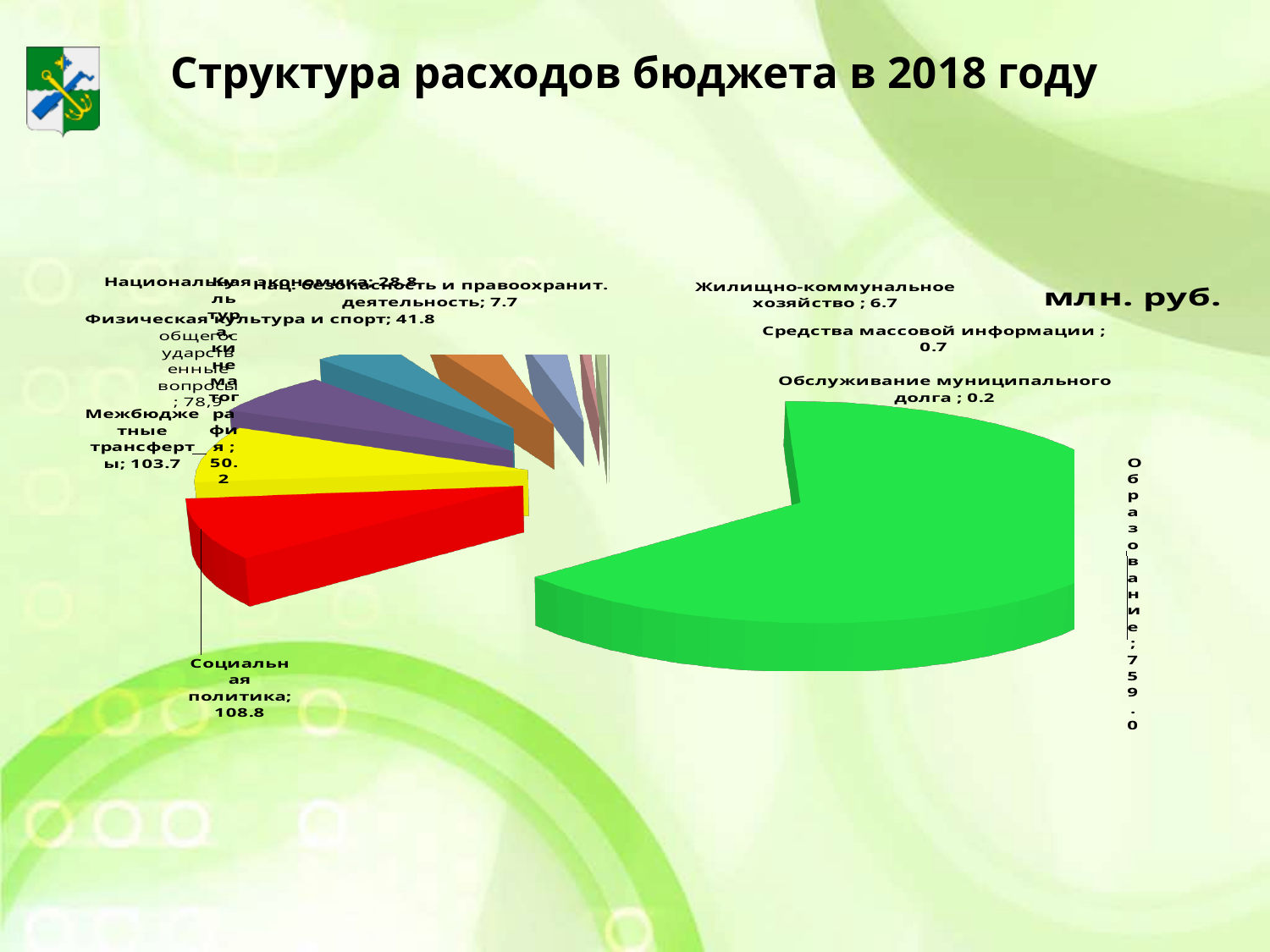
What is the value for Физическая культура и спорт? 41.8 Which category has the smallest value? Обслуживание муниципального долга Which category has the largest slice of the pie? Образование In what units are the chart values given? млн. руб. What is the value for Обслуживание муниципального долга? 0.2 Which is larger: Физическая культура и спорт or Национальная экономика? Физическая культура и спорт What is the difference between the values for Социальная политика and Межбюджетные трансферты? 5.1 What kind of chart is shown on the slide? pie chart What is the value for Социальная политика? 108.8 What is the value for Межбюджетные трансферты? 103.7 What is the value for Образование? 759.0 What is the value for Жилищно-коммунальное хозяйство? 6.7